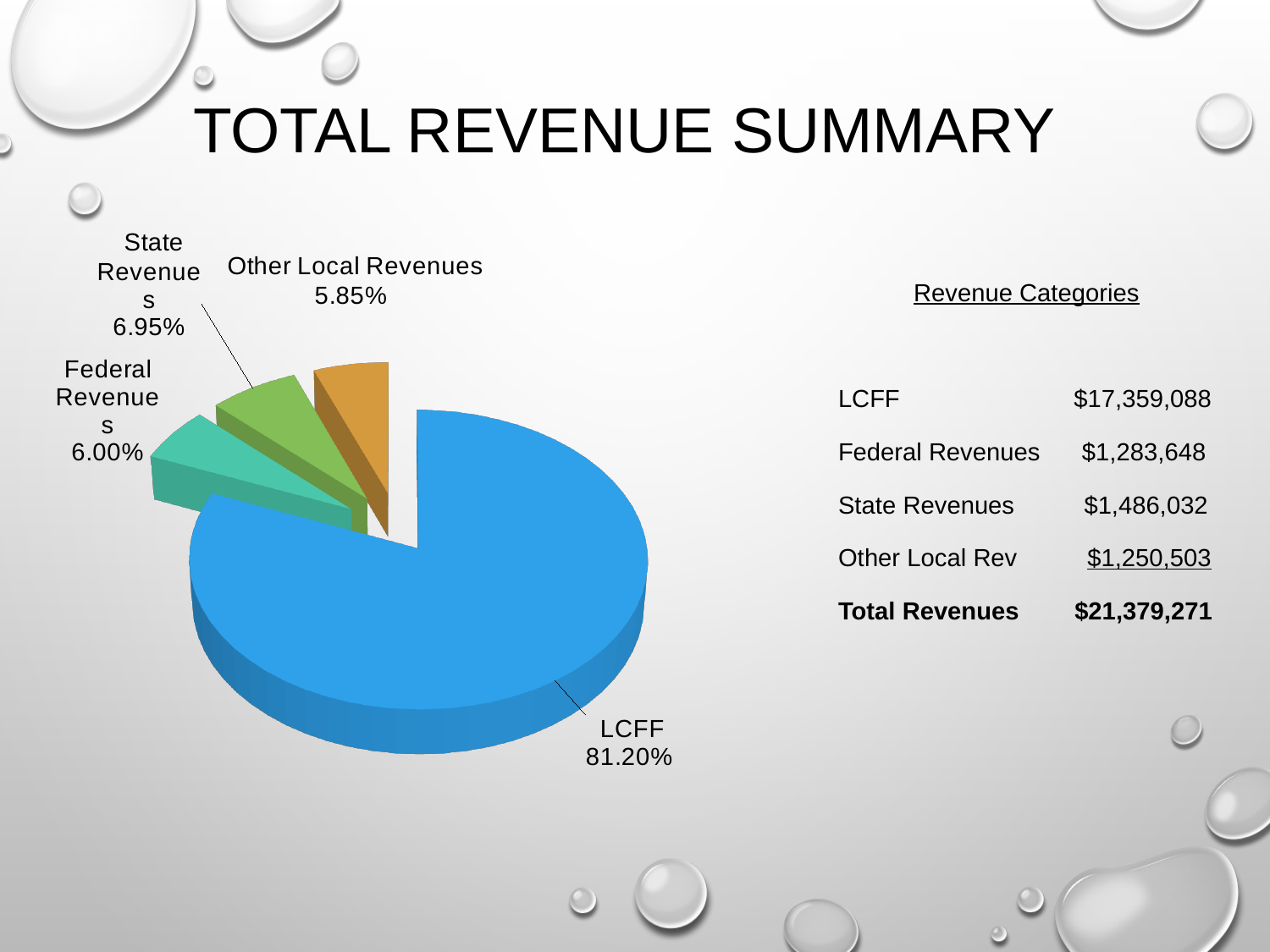
What colour is the LCFF slice of the pie chart? Blue What type of chart is shown on the slide? Pie chart Which slice is larger, State Revenues or Other Local Revenues? State Revenues What share of the pie does Other Local Revenues represent? 5.85% What is the difference in percentage points between the State Revenues slice and the Federal Revenues slice? 0.95 What share of the pie does Federal Revenues represent? 6.00% How many slices does the pie chart have? 4 What is the title of the slide containing the pie chart? TOTAL REVENUE SUMMARY Which category has the largest slice of the pie? LCFF What share of the pie does LCFF represent? 81.20% Which category has the smallest slice of the pie? Other Local Revenues